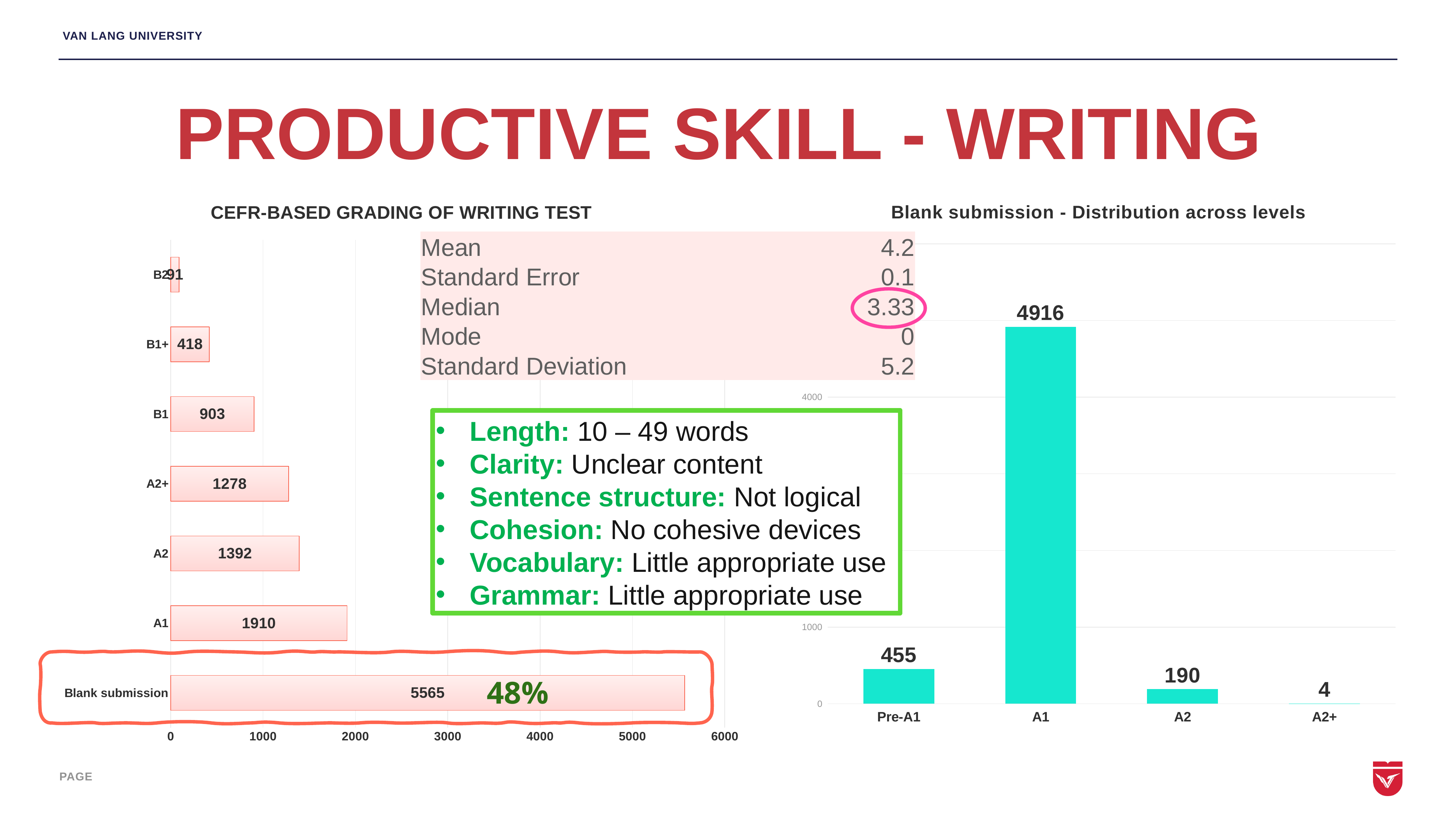
In the 'CEFR-BASED GRADING OF WRITING TEST' chart, what is the value for A1? 1910 In the 'Blank submission - Distribution across levels' chart, which level has the lowest value? A2+ In the 'CEFR-BASED GRADING OF WRITING TEST' chart, what is the difference between the values for A2 and A2+? 114 In the 'CEFR-BASED GRADING OF WRITING TEST' chart, what is the value for Blank submission? 5565 In the 'CEFR-BASED GRADING OF WRITING TEST' chart, which category has the highest value? Blank submission In the 'Blank submission - Distribution across levels' chart, what is the difference between the values for Pre-A1 and A2? 265 In the 'CEFR-BASED GRADING OF WRITING TEST' chart, which is larger, the value for B1 or the value for A2+? A2+ What kind of chart is the 'Blank submission - Distribution across levels' chart? Bar chart In the 'Blank submission - Distribution across levels' chart, what is the value for A1? 4916 In the 'CEFR-BASED GRADING OF WRITING TEST' chart, what is the value for B1+? 418 How many categories are shown in the 'CEFR-BASED GRADING OF WRITING TEST' chart? 7 How many levels are shown in the 'Blank submission - Distribution across levels' chart? 4